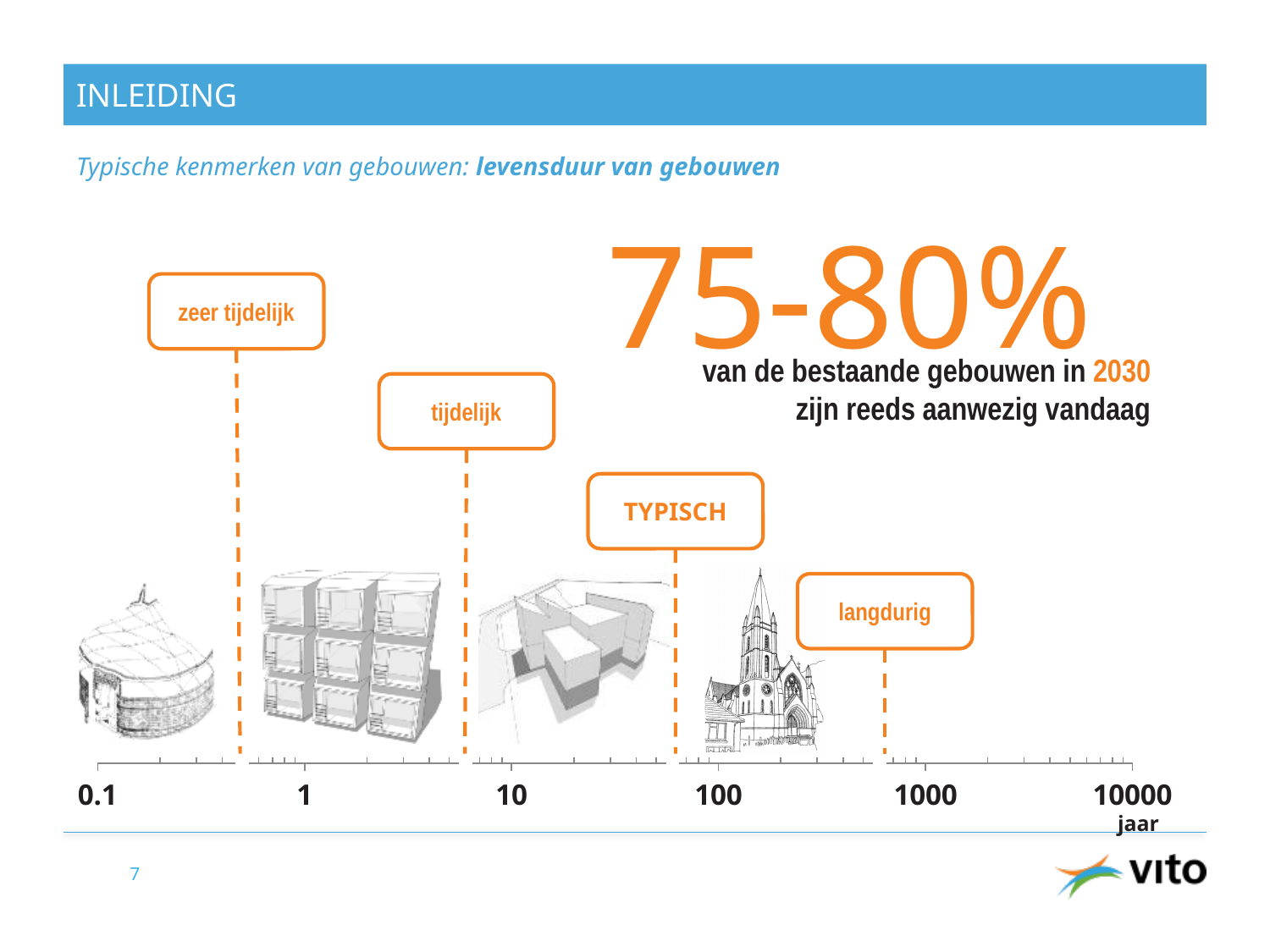
Is the marker for 'TYPISCH' greater or less than 100 years on the axis? less How many lifespan categories are labelled along the timeline? 4 What percentage of the buildings existing in 2030 does the slide say are already present today? 75-80% What is the lowest value printed on the timeline axis? 0.1 Which labelled category is placed furthest to the right (longest lifespan) on the timeline? langdurig What unit is shown at the end of the timeline axis? jaar Is the marker for 'zeer tijdelijk' greater or less than 1 year on the axis? less Is the marker for 'tijdelijk' greater or less than 10 years on the axis? less What is the highest value printed on the timeline axis? 10000 Which category is positioned at a longer lifespan on the axis, 'tijdelijk' or 'TYPISCH'? TYPISCH Which labelled category is placed furthest to the left (shortest lifespan) on the timeline? zeer tijdelijk